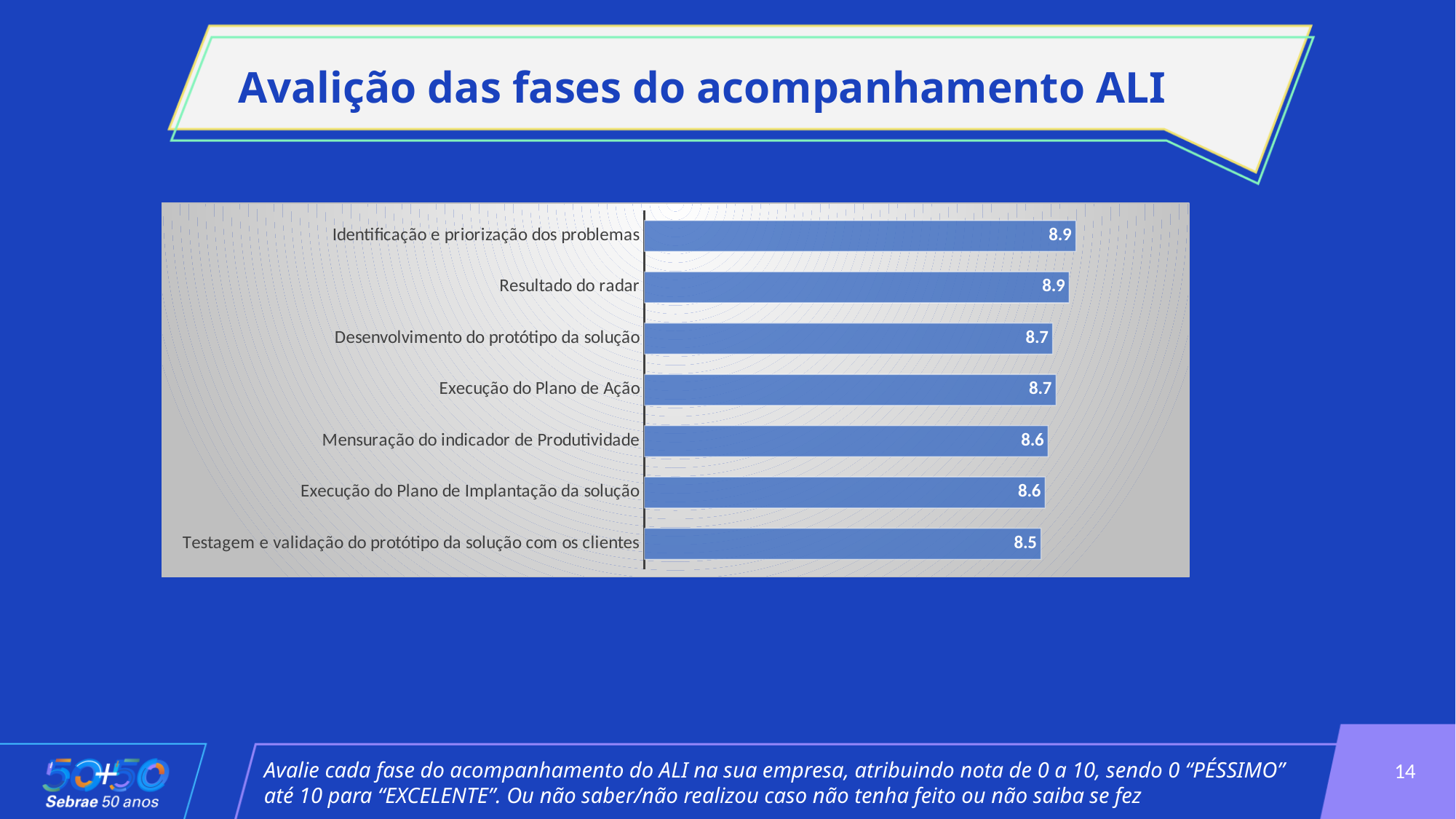
What is the value for "Resultado do radar"? 8.9 What is the value for "Identificação e priorização dos problemas"? 8.9 What is the value for "Desenvolvimento do protótipo da solução"? 8.7 What is the value for "Execução do Plano de Implantação da solução"? 8.6 What is the difference between the values for "Identificação e priorização dos problemas" and "Testagem e validação do protótipo da solução com os clientes"? 0.4 What is the value for "Mensuração do indicador de Produtividade"? 8.6 What kind of chart is shown on the slide? Bar chart What is the value for "Execução do Plano de Ação"? 8.7 How many categories are shown in the chart? 7 Which has a larger value, "Resultado do radar" or "Testagem e validação do protótipo da solução com os clientes"? Resultado do radar Which category has the lowest value? Testagem e validação do protótipo da solução com os clientes What is the value for "Testagem e validação do protótipo da solução com os clientes"? 8.5